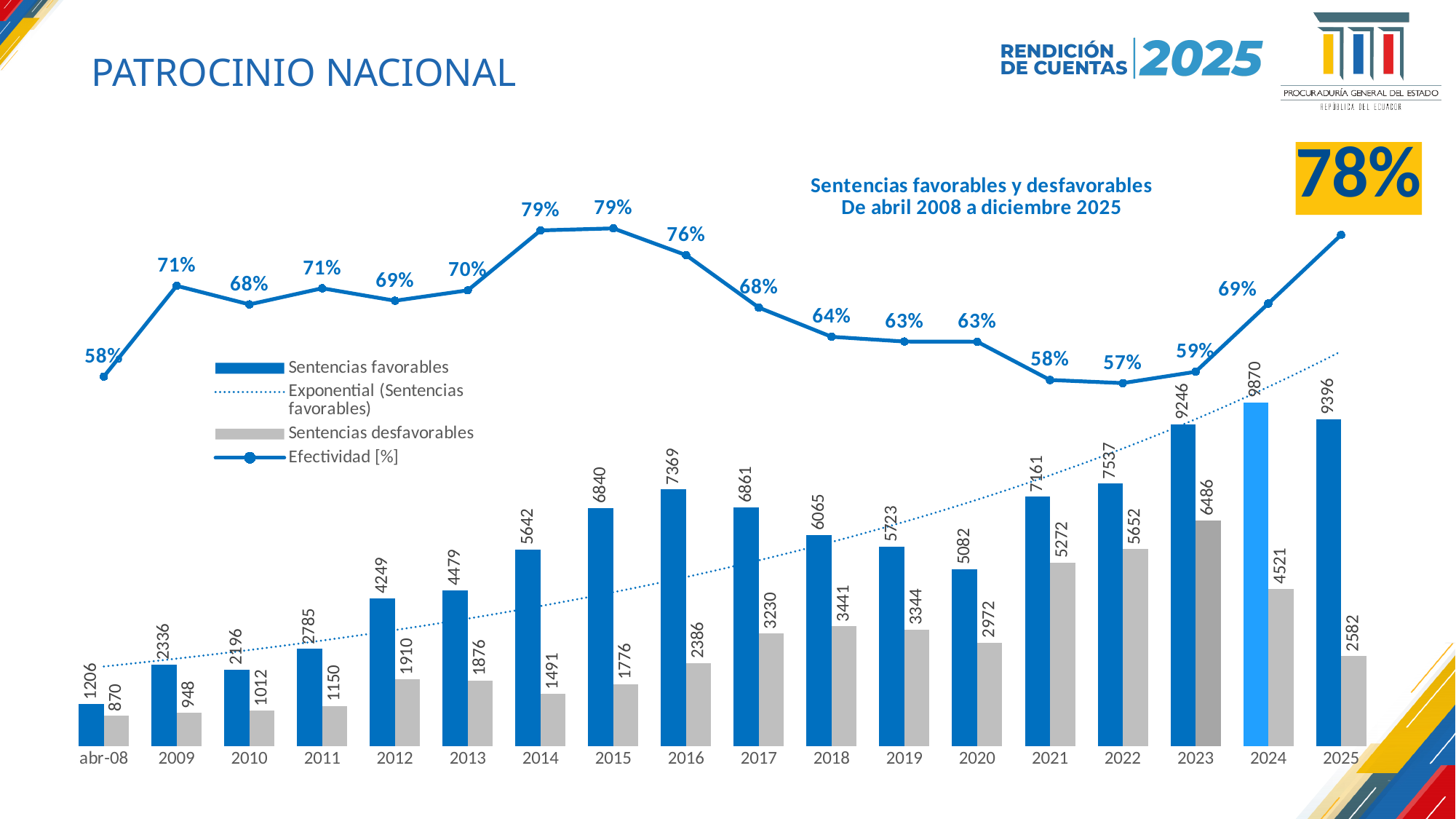
What is the value of Sentencias favorables for 2024? 9870 What kind of chart is shown on the slide? Combined bar and line chart How many time periods are shown on the x axis? 18 In which year is Efectividad [%] at its lowest? 2022 What is the difference between Sentencias favorables and Sentencias desfavorables in 2025? 6814 Which is larger: Sentencias desfavorables in 2021 or in 2024? 2021 Which category has the lowest value of Sentencias desfavorables? abr-08 What is the title of the chart? Sentencias favorables y desfavorables De abril 2008 a diciembre 2025 Which year has the highest value of Sentencias favorables? 2024 What is the Efectividad [%] value for 2016? 76% What is the value of Sentencias desfavorables for 2023? 6486 How many entries does the legend list? 4